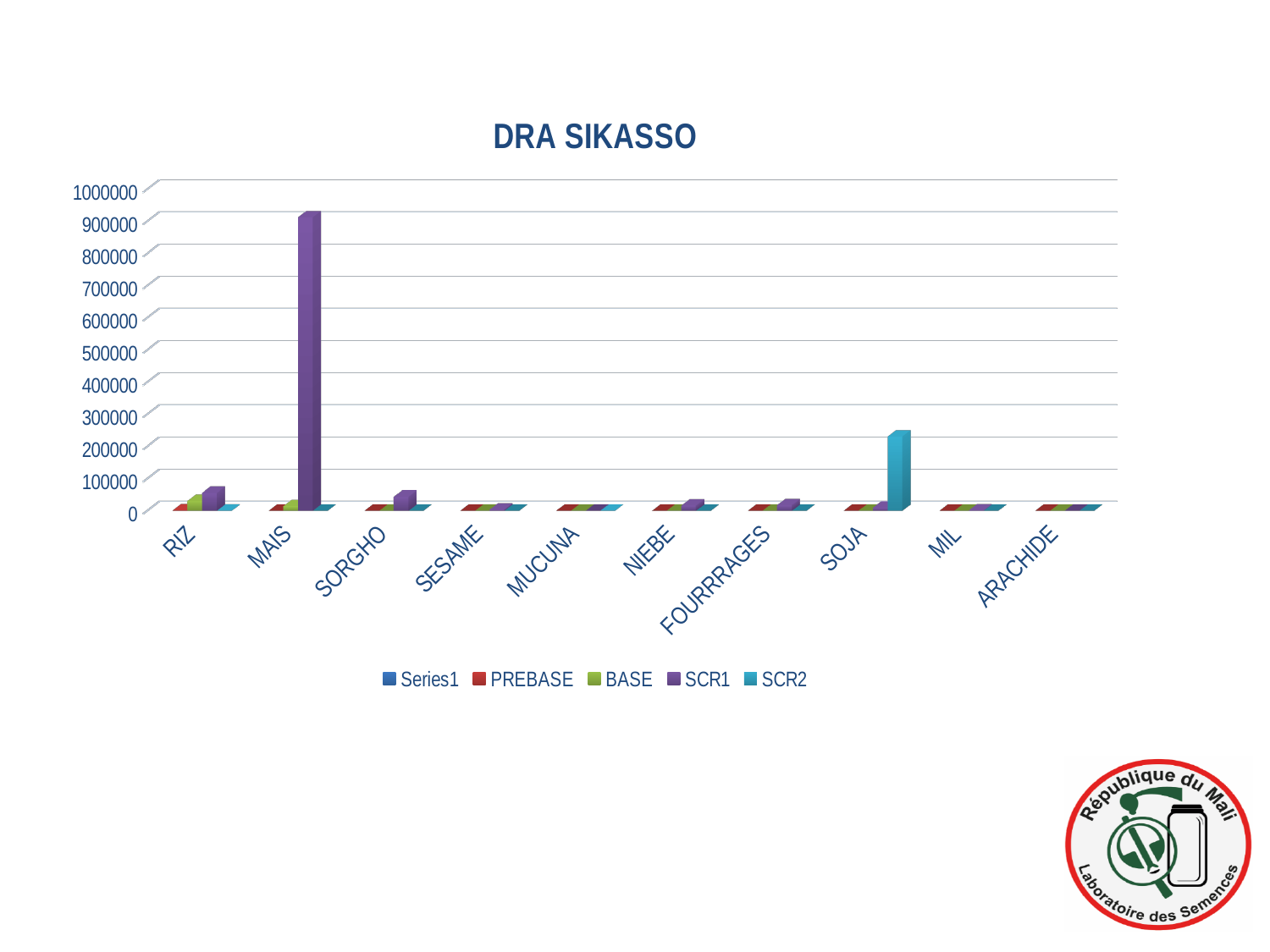
Is the SCR2 value for SOJA greater or less than 300000? less Which is larger: the SCR1 value for MAIS or the SCR2 value for SOJA? SCR1 value for MAIS Which series is shown in purple in the legend? SCR1 What kind of chart is shown on the slide? Bar chart How many series does the legend list? 5 Is the SCR1 value for SORGHO greater or less than 100000? less Is the SCR2 value for SOJA greater or less than 100000? greater Which category has the tallest SCR1 bar? MAIS How many categories are shown on the x axis of the chart? 10 Which category has the tallest SCR2 bar? SOJA What is the title of the chart? DRA SIKASSO